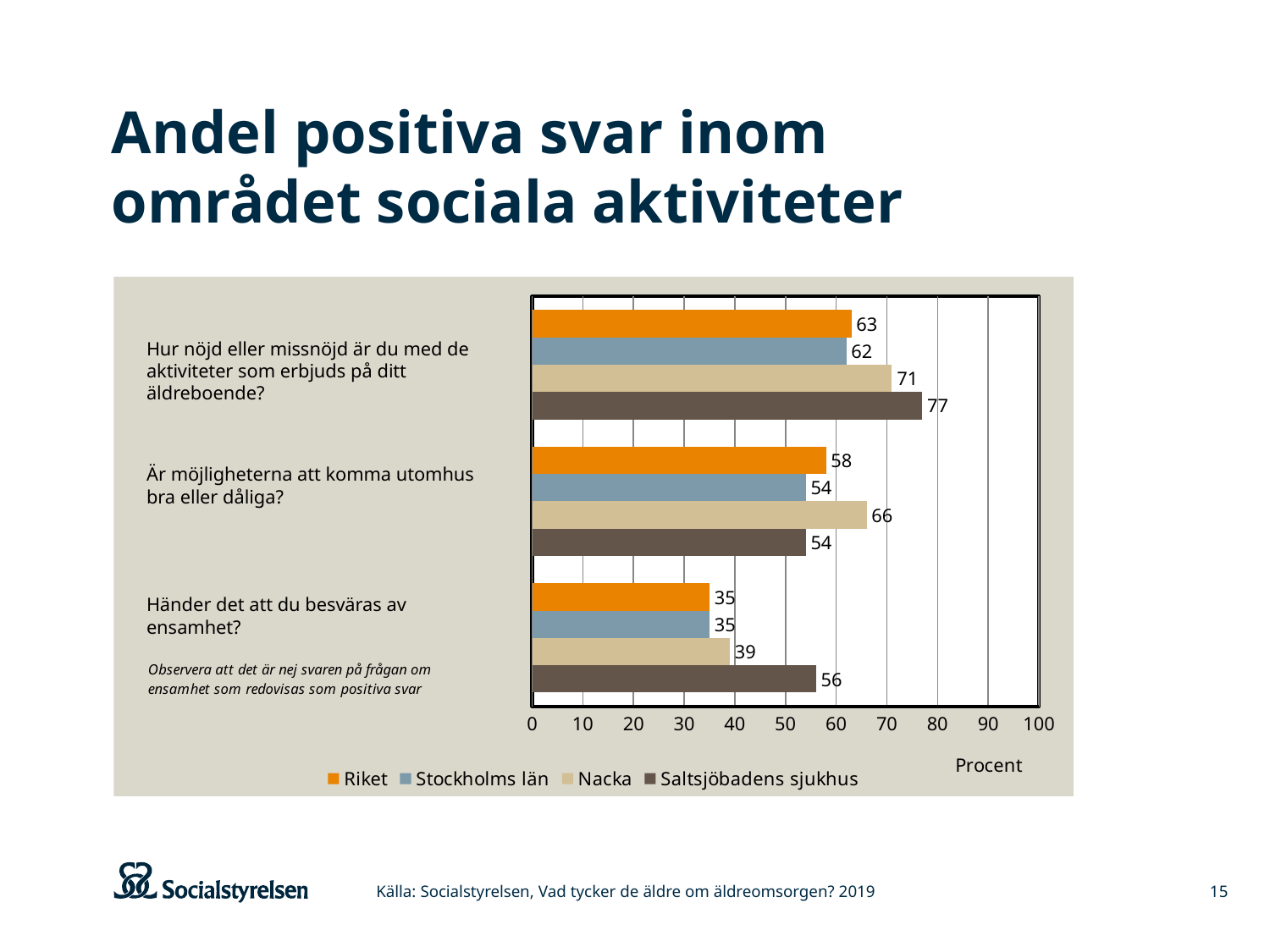
How many series does the legend list? 4 How many questions (categories) are shown in the chart? 3 What value is shown for Saltsjöbadens sjukhus on the question "Hur nöjd eller missnöjd är du med de aktiviteter som erbjuds på ditt äldreboende?"? 77 What value is shown for Nacka on the question "Är möjligheterna att komma utomhus bra eller dåliga?"? 66 What unit is labelled on the horizontal axis of the chart? Procent Which is larger on the question "Är möjligheterna att komma utomhus bra eller dåliga?": Riket or Nacka? Nacka Which series has the lowest value for the question "Är möjligheterna att komma utomhus bra eller dåliga?"? Stockholms län and Saltsjöbadens sjukhus (both 54) What value is shown for Riket on the question "Händer det att du besväras av ensamhet?"? 35 What kind of chart is shown on the slide? Bar chart Is the value for Stockholms län on the question "Hur nöjd eller missnöjd är du med de aktiviteter som erbjuds på ditt äldreboende?" greater or less than 50? greater What is the difference between Saltsjöbadens sjukhus and Nacka on the question "Händer det att du besväras av ensamhet?"? 17 Which series has the highest value for the question "Hur nöjd eller missnöjd är du med de aktiviteter som erbjuds på ditt äldreboende?"? Saltsjöbadens sjukhus